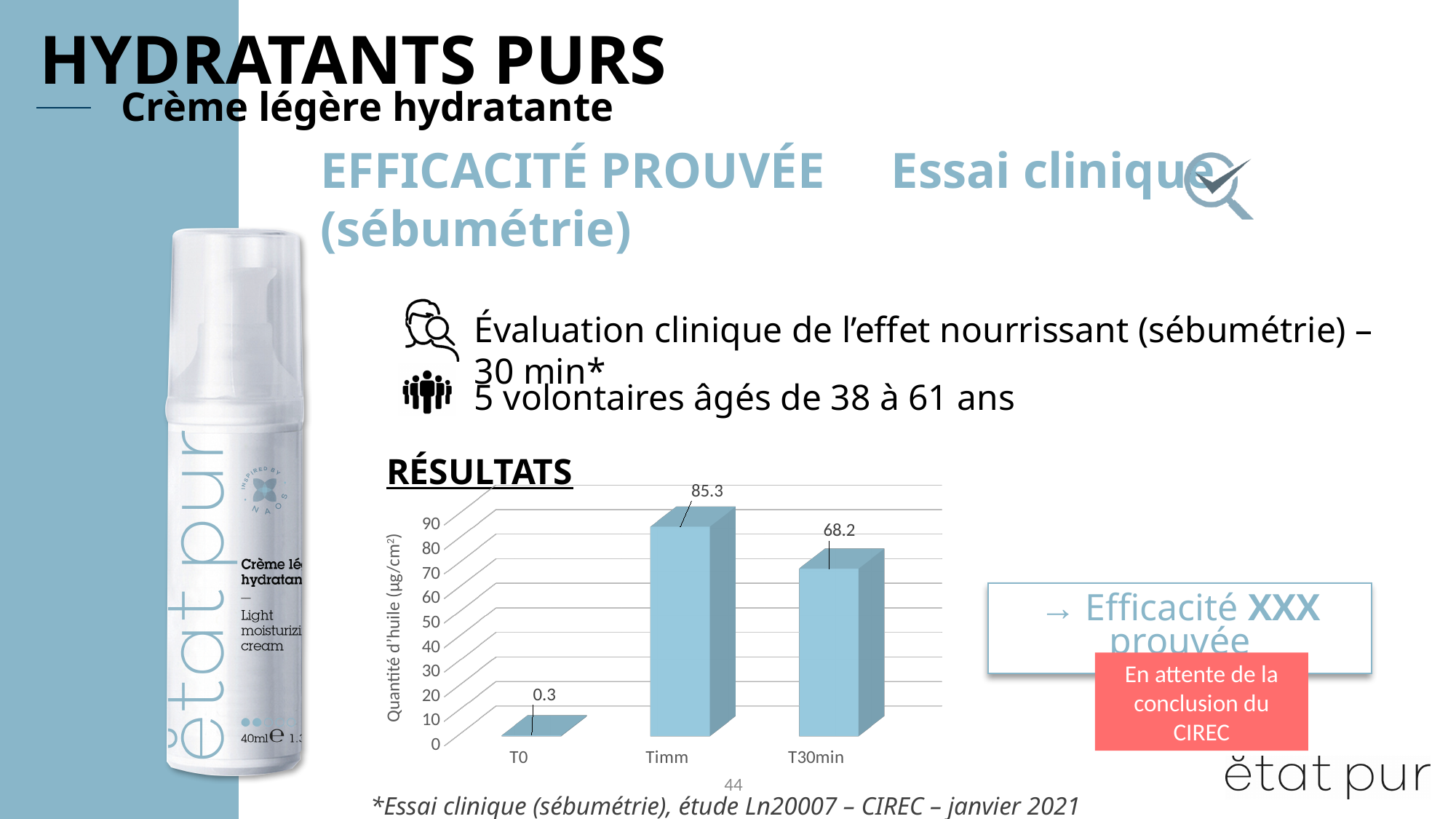
What is the value for T30min? 68.2 Which category has the lowest value? T0 What is the difference between the values for T30min and T0? 67.9 Which is larger, the value for Timm or the value for T30min? Timm How many categories are shown on the x axis? 3 What is the label of the vertical axis? Quantité d'huile (µg/cm²) What is the value for T0? 0.3 Which category has the highest value? Timm What kind of chart is shown? bar chart What is the value for Timm? 85.3 What is the difference between the values for Timm and T30min? 17.1 Is the value for T30min greater or less than 60? greater